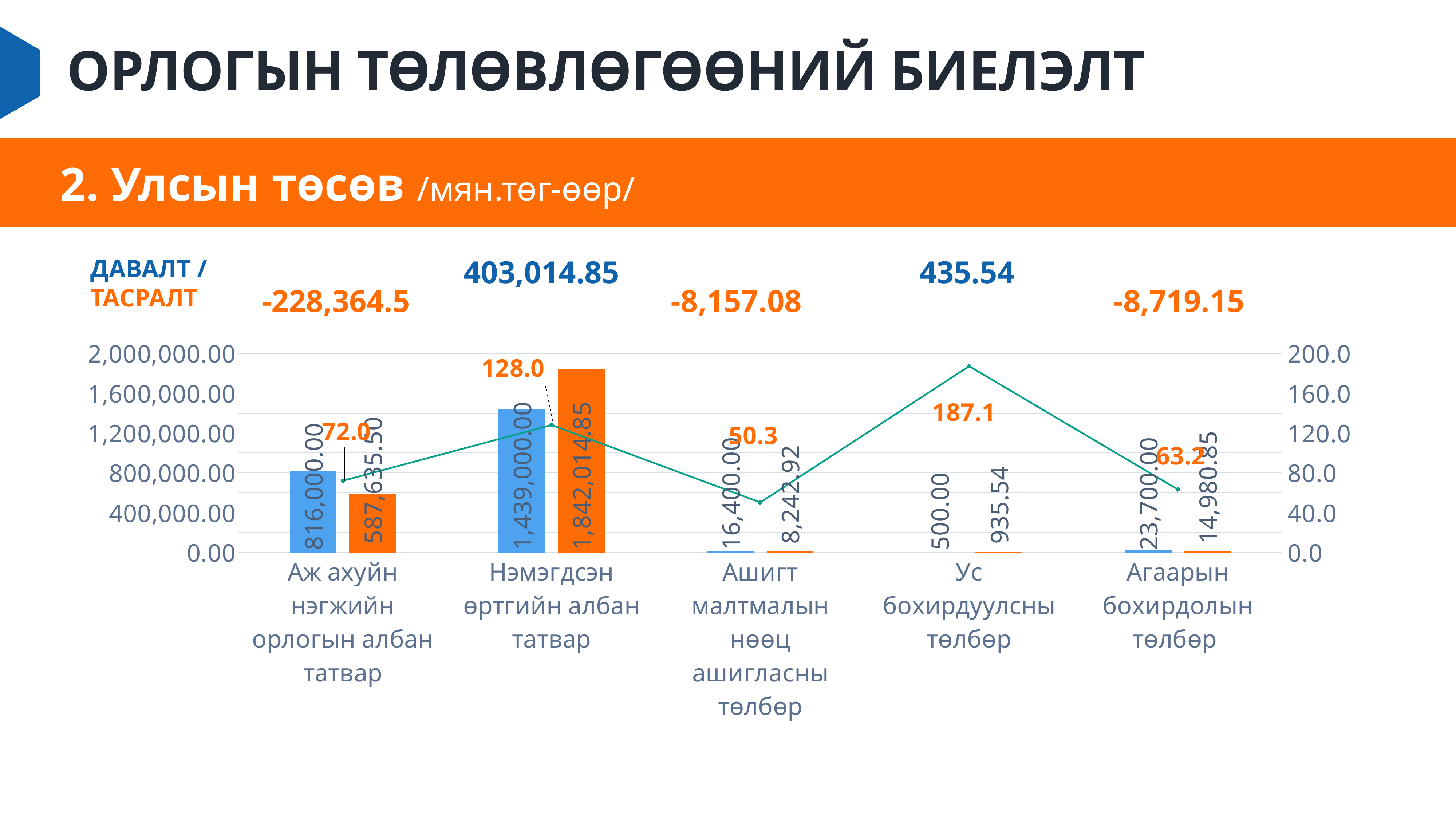
What is the value of the orange bar for Агаарын бохирдолын төлбөр? 14,980.85 Is the line value for Нэмэгдсэн өртгийн албан татвар greater or less than 120.0? greater Which is larger for Аж ахуйн нэгжийн орлогын албан татвар, the blue bar or the orange bar? the blue bar What is the value of the blue bar for Аж ахуйн нэгжийн орлогын албан татвар? 816,000.00 Which category has the highest value on the green line? Ус бохирдуулсны төлбөр What is the value of the orange bar for Нэмэгдсэн өртгийн албан татвар? 1,842,014.85 What is the line value shown for Ус бохирдуулсны төлбөр? 187.1 How many categories are shown on the x axis? 5 Which category has the lowest value on the green line? Ашигт малтмалын нөөц ашигласны төлбөр What kind of chart is this? a combined bar and line chart What is the difference between the orange bar and the blue bar for Нэмэгдсэн өртгийн албан татвар? 403,014.85 What is the value of the blue bar for Ус бохирдуулсны төлбөр? 500.00